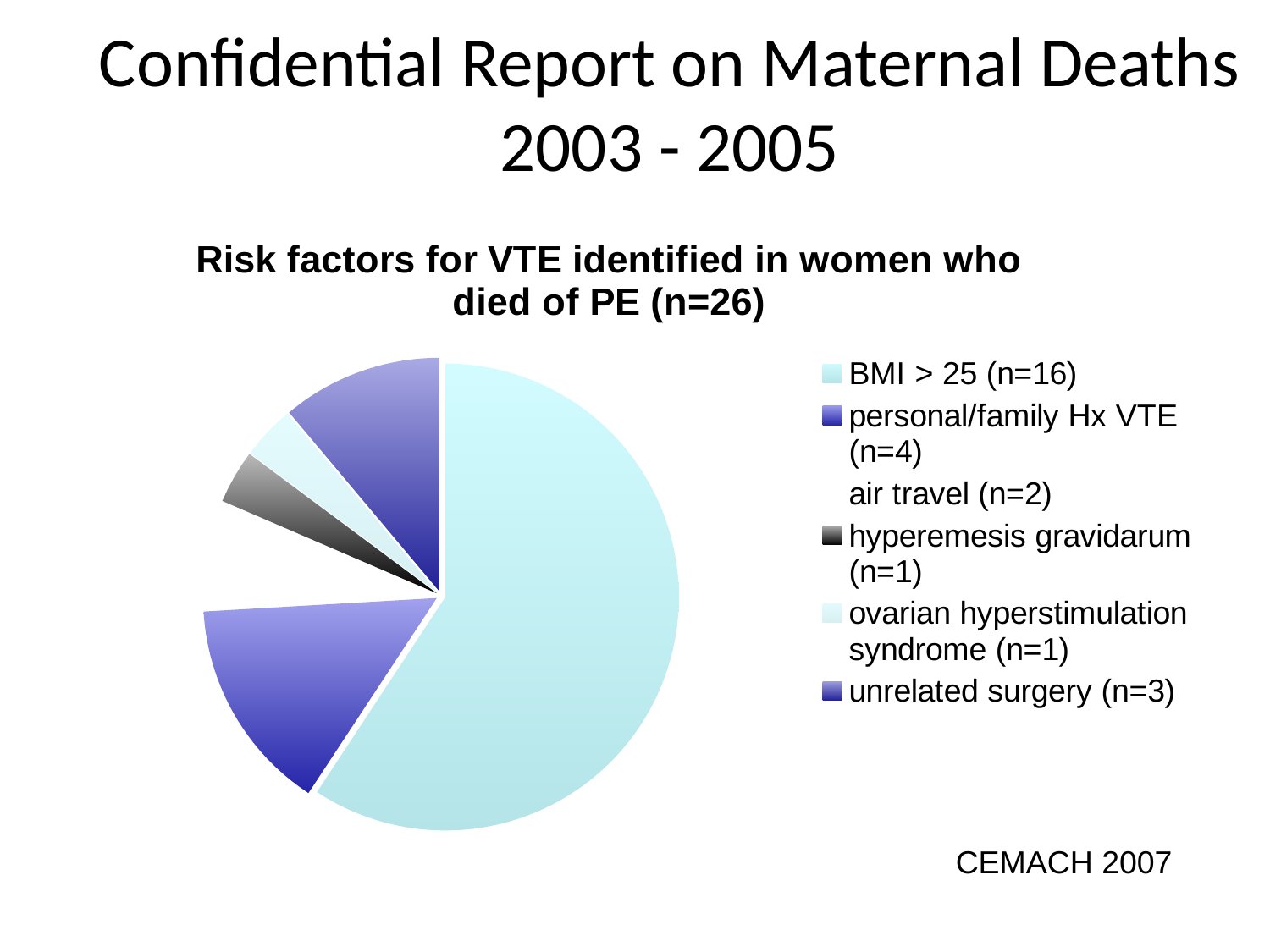
Which two risk factors have the smallest value (n=1)? hyperemesis gravidarum and ovarian hyperstimulation syndrome Which risk factor has the largest slice of the pie? BMI > 25 How many women in the chart had BMI > 25? 16 How many risk factor categories does the pie chart show? 6 What is the difference between the number of women with BMI > 25 and those with personal/family Hx VTE? 12 How many women had air travel as a risk factor? 2 What is the title of the pie chart? Risk factors for VTE identified in women who died of PE (n=26) Which is larger: unrelated surgery or air travel? unrelated surgery What kind of chart is shown on the slide? Pie chart What is the n value for unrelated surgery? 3 What source is cited below the chart? CEMACH 2007 What is the n value for personal/family Hx VTE? 4